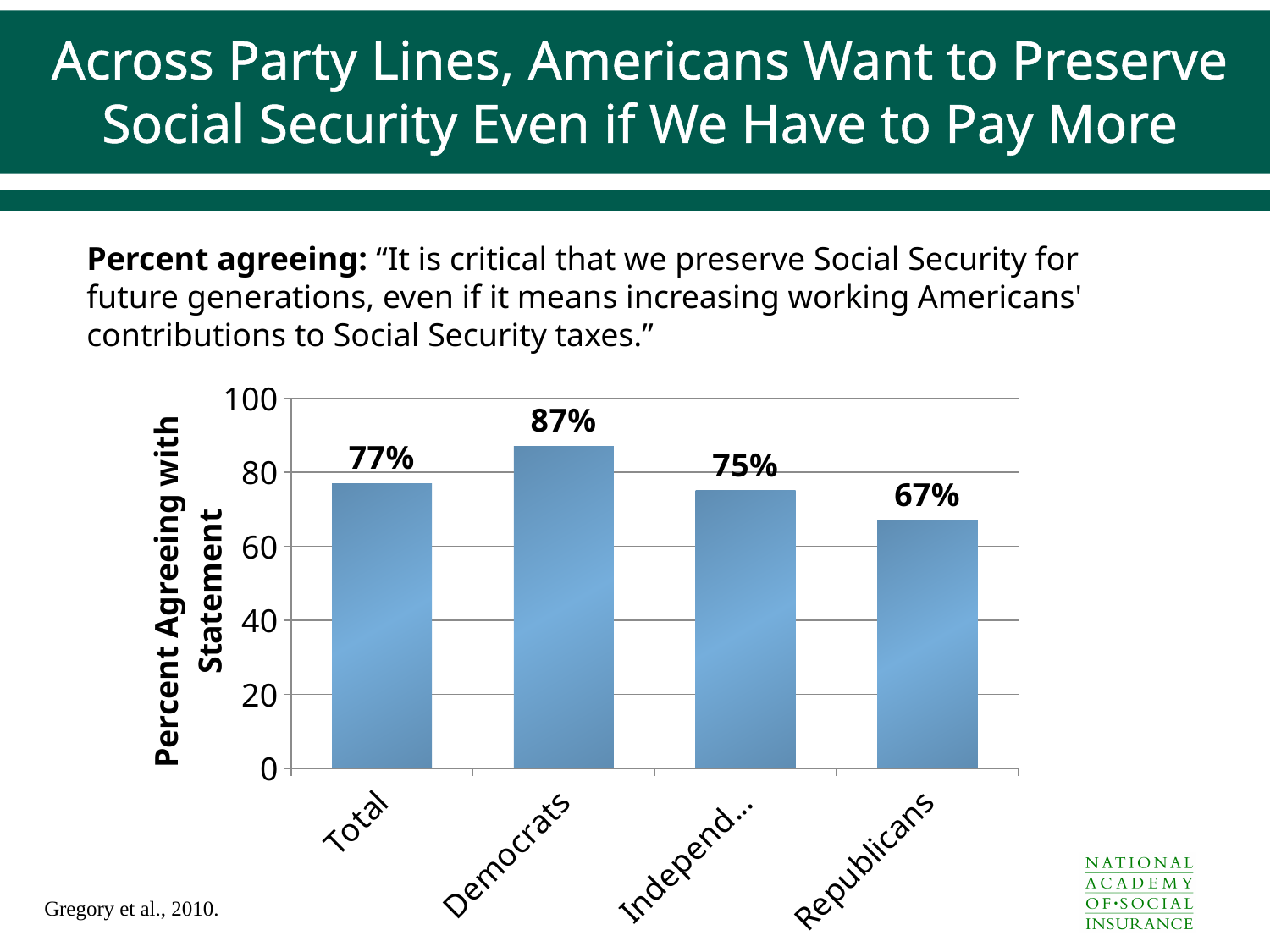
What is the value shown for the Total category? 77% Is the value for Democrats greater or less than 80? greater Which category has the lowest percent agreeing with the statement? Republicans What is the difference between the Total value and the Republicans value? 10 percentage points What is the label on the vertical axis of the chart? Percent Agreeing with Statement What percent of Democrats agree with the statement? 87% Which is larger, the value for Total or the value for Republicans? Total Which category has the highest percent agreeing with the statement? Democrats What is the difference between the values for Democrats and Republicans? 20 percentage points What is the value shown for Republicans? 67% What kind of chart is shown on the slide? Bar chart How many categories are shown on the x axis? 4